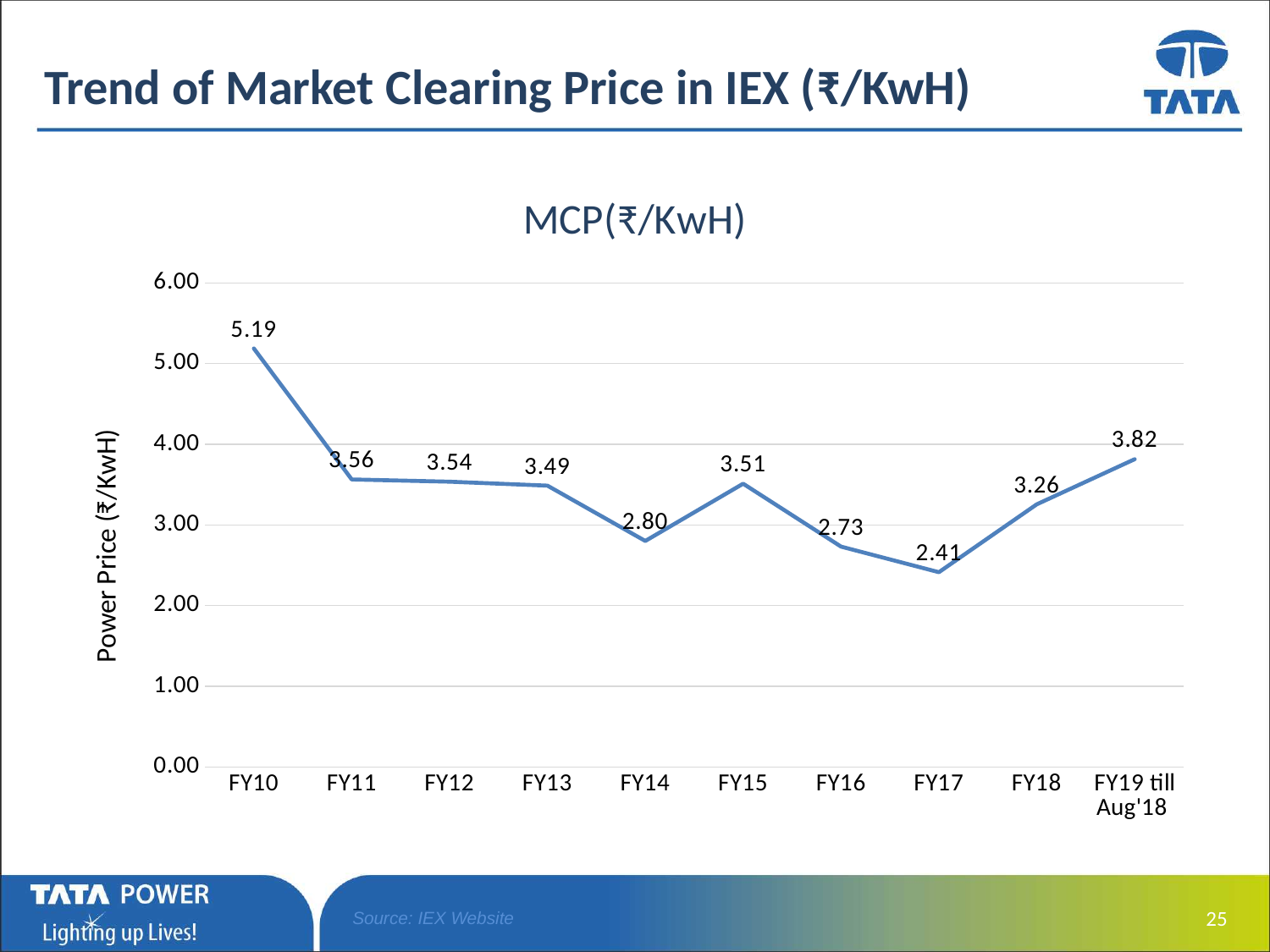
Which is larger, the MCP in FY15 or in FY16? FY15 What is the MCP value for FY19 till Aug'18? 3.82 What is the MCP value for FY17? 2.41 Does the MCP rise or fall from FY17 to FY19 till Aug'18? rise What kind of chart is shown on the slide? line chart What is the difference between the MCP in FY10 and FY11? 1.63 What is the title of the chart? MCP(₹/KwH) Which fiscal year has the highest MCP? FY10 Which fiscal year has the lowest MCP? FY17 What is the MCP value for FY10? 5.19 How many data points are plotted on the chart? 10 Is the MCP value for FY14 greater or less than 3.00? less